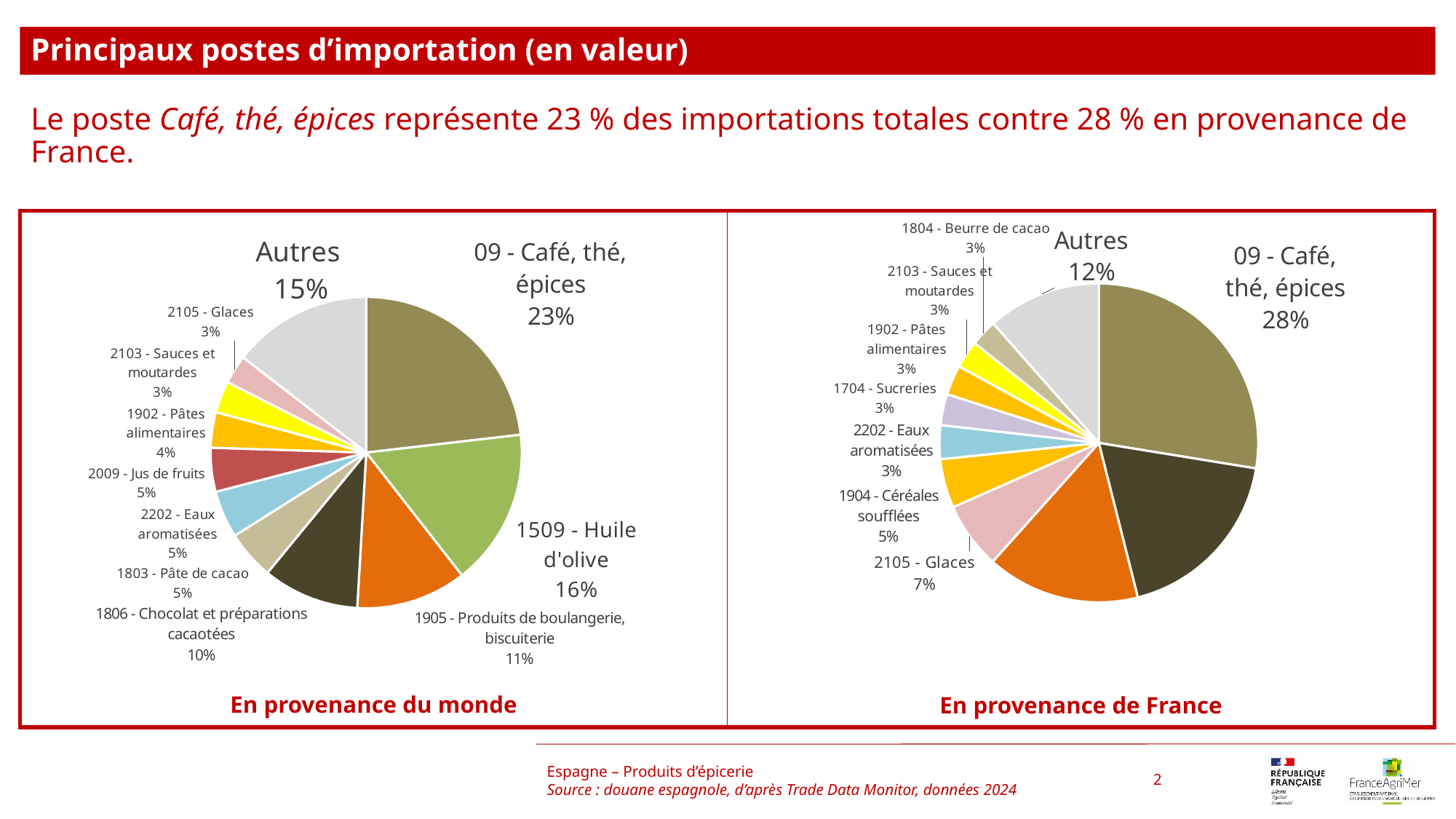
In the 'En provenance du monde' pie chart, what is the share of '1806 - Chocolat et préparations cacaotées'? 10% In the 'En provenance du monde' pie chart, what share does '09 - Café, thé, épices' represent? 23% In the 'En provenance de France' pie chart, what share does '09 - Café, thé, épices' represent? 28% Which is larger: the share of 'Autres' in the 'En provenance du monde' chart or in the 'En provenance de France' chart? En provenance du monde How many slices does the 'En provenance du monde' pie chart have? 11 In the 'En provenance du monde' pie chart, which labelled category has the largest share? 09 - Café, thé, épices In the 'En provenance de France' pie chart, what is the share of '1904 - Céréales soufflées'? 5% In the 'En provenance du monde' pie chart, what is the difference in share between '09 - Café, thé, épices' and '1509 - Huile d'olive'? 7 percentage points In the 'En provenance du monde' pie chart, what is the share of '1509 - Huile d'olive'? 16% In the 'En provenance de France' pie chart, what is the share of '2105 - Glaces'? 7% What type of chart is used on this slide? Pie chart What is the title of the slide? Principaux postes d'importation (en valeur)